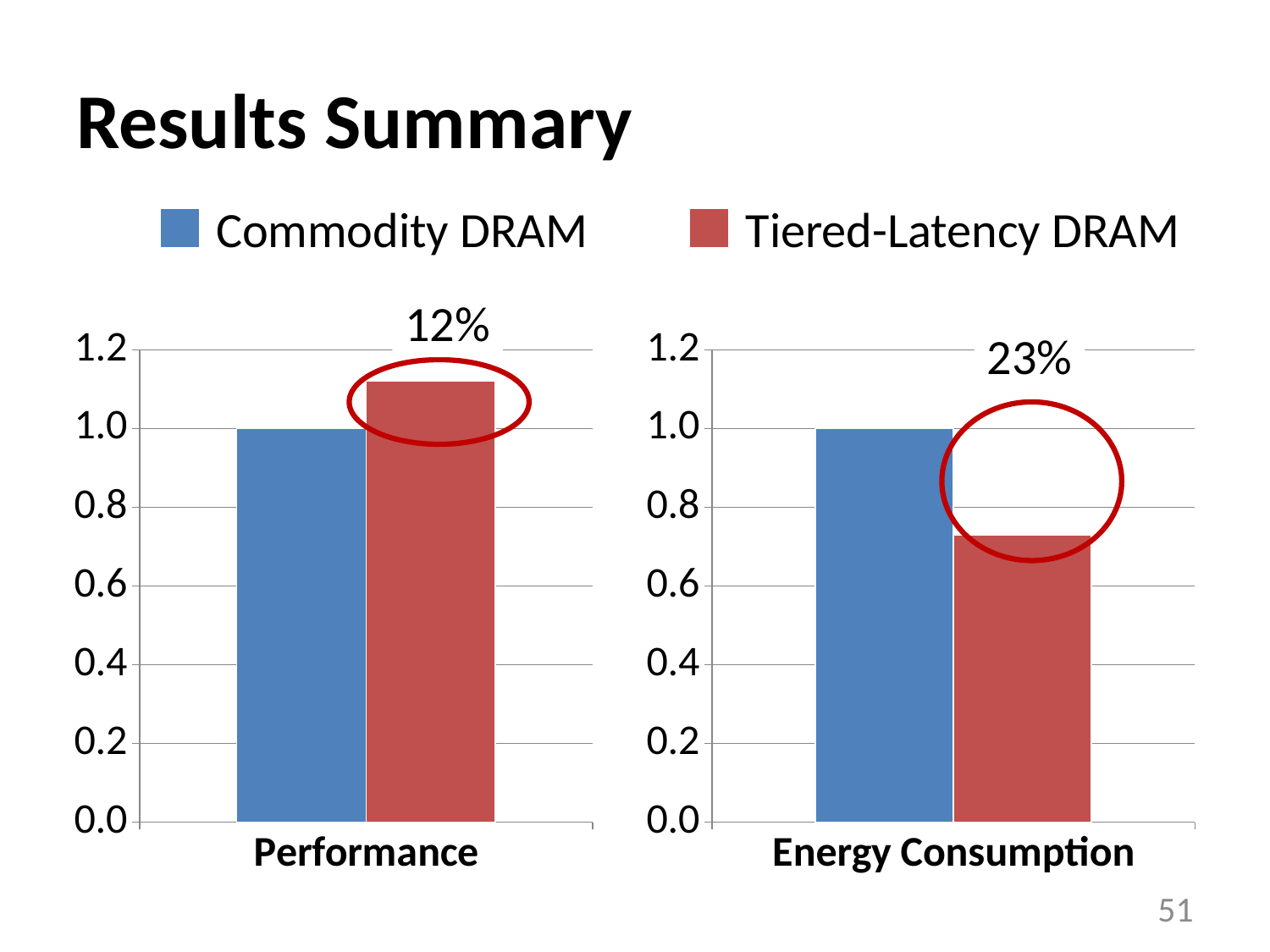
What percentage annotation is shown in the Energy Consumption chart? 23% In the Performance chart, is the value for Tiered-Latency DRAM greater or less than 1.0? greater In the Energy Consumption chart, what is the value for Commodity DRAM? 1.0 In the Performance chart, what is the value for Commodity DRAM? 1.0 In the Energy Consumption chart, is the Commodity DRAM bar larger or smaller than the Tiered-Latency DRAM bar? larger How many series does the legend list? 2 What percentage annotation is shown above the Tiered-Latency DRAM bar in the Performance chart? 12% In the Energy Consumption chart, which series has the lower bar? Tiered-Latency DRAM In the Energy Consumption chart, is the value for Tiered-Latency DRAM greater or less than 0.8? less How many bars are in the Energy Consumption chart? 2 In the Performance chart, which series has the higher bar? Tiered-Latency DRAM What kind of chart is the Performance chart? bar chart